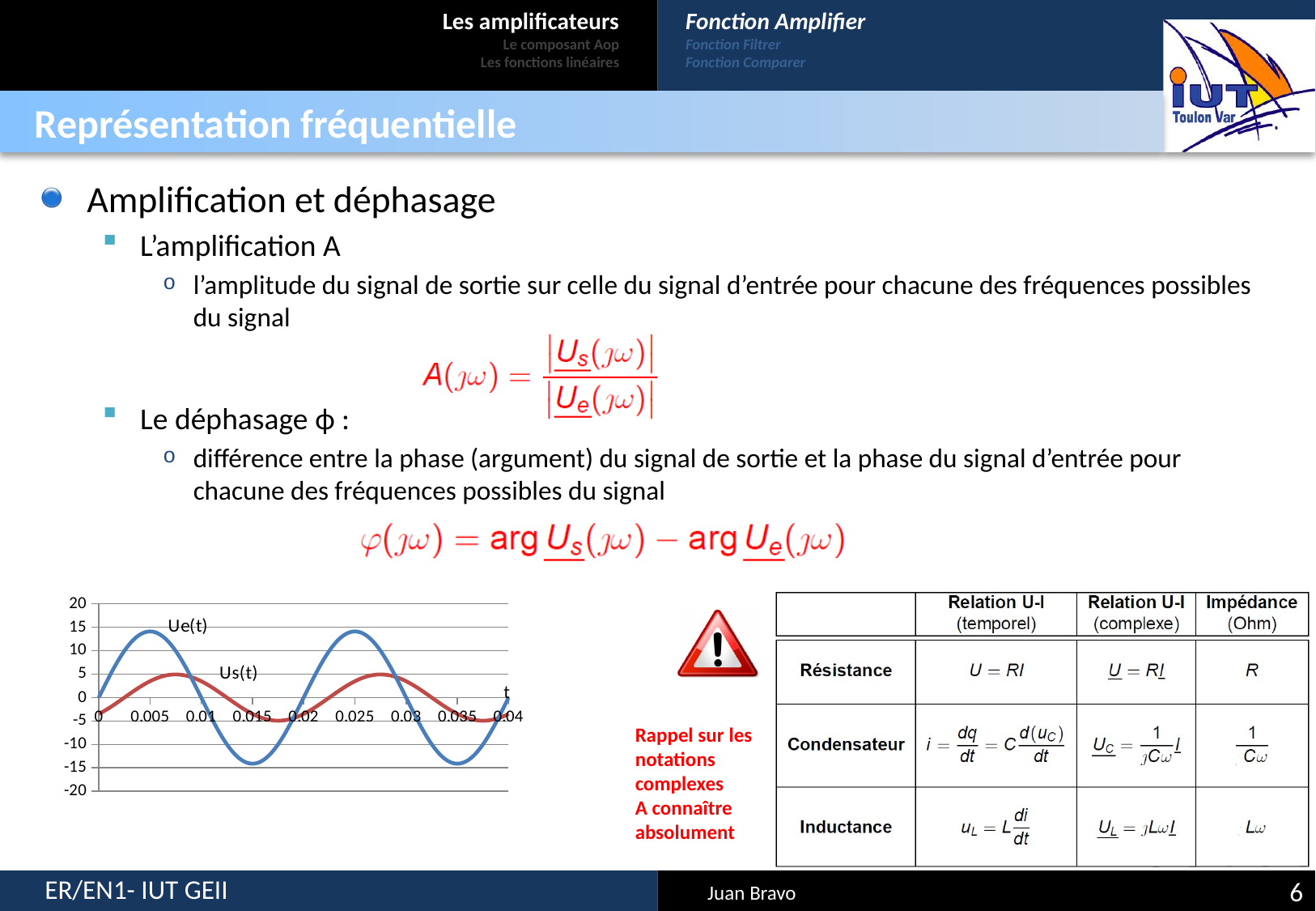
In the chart at the bottom left, is the minimum value of Ue(t) greater or less than -10? less What is the last tick value on the horizontal axis of the chart at the bottom left? 0.04 In the chart at the bottom left, is the peak value of Us(t) greater or less than 10? less How many tick labels are shown on the horizontal axis of the chart at the bottom left? 9 In the chart at the bottom left, is the peak value of Ue(t) greater or less than 10? greater In the chart at the bottom left, which series has the larger amplitude, Ue(t) or Us(t)? Ue(t) What is the highest value shown on the vertical axis of the chart at the bottom left? 20 What kind of chart is shown at the bottom left of the slide? line chart How many series are plotted in the chart at the bottom left of the slide? 2 What are the names of the two series plotted in the chart at the bottom left? Ue(t) and Us(t)